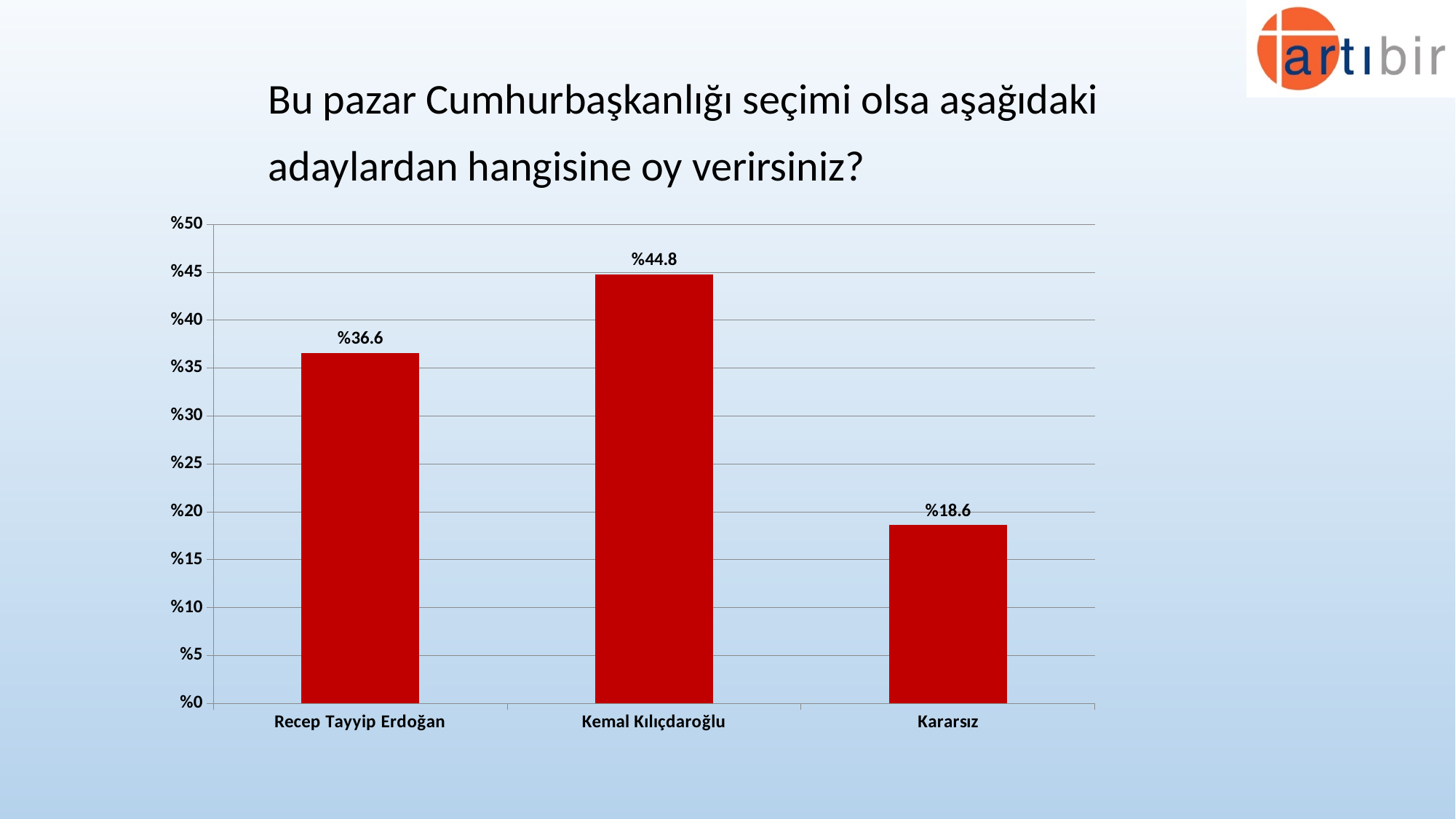
Which category has the highest value? Kemal Kılıçdaroğlu What is the value for Recep Tayyip Erdoğan? %36.6 What colour are the bars in the chart? Red What is the difference between the values for Recep Tayyip Erdoğan and Kararsız? %18.0 What kind of chart is shown on the slide? Bar chart What is the difference between the values for Kemal Kılıçdaroğlu and Recep Tayyip Erdoğan? %8.2 What is the value for Kemal Kılıçdaroğlu? %44.8 How many categories are shown on the x axis? 3 Is the value for Kemal Kılıçdaroğlu greater or less than %40? greater Which category has the lowest value? Kararsız Which is larger, the value for Recep Tayyip Erdoğan or the value for Kararsız? Recep Tayyip Erdoğan What is the value for Kararsız? %18.6